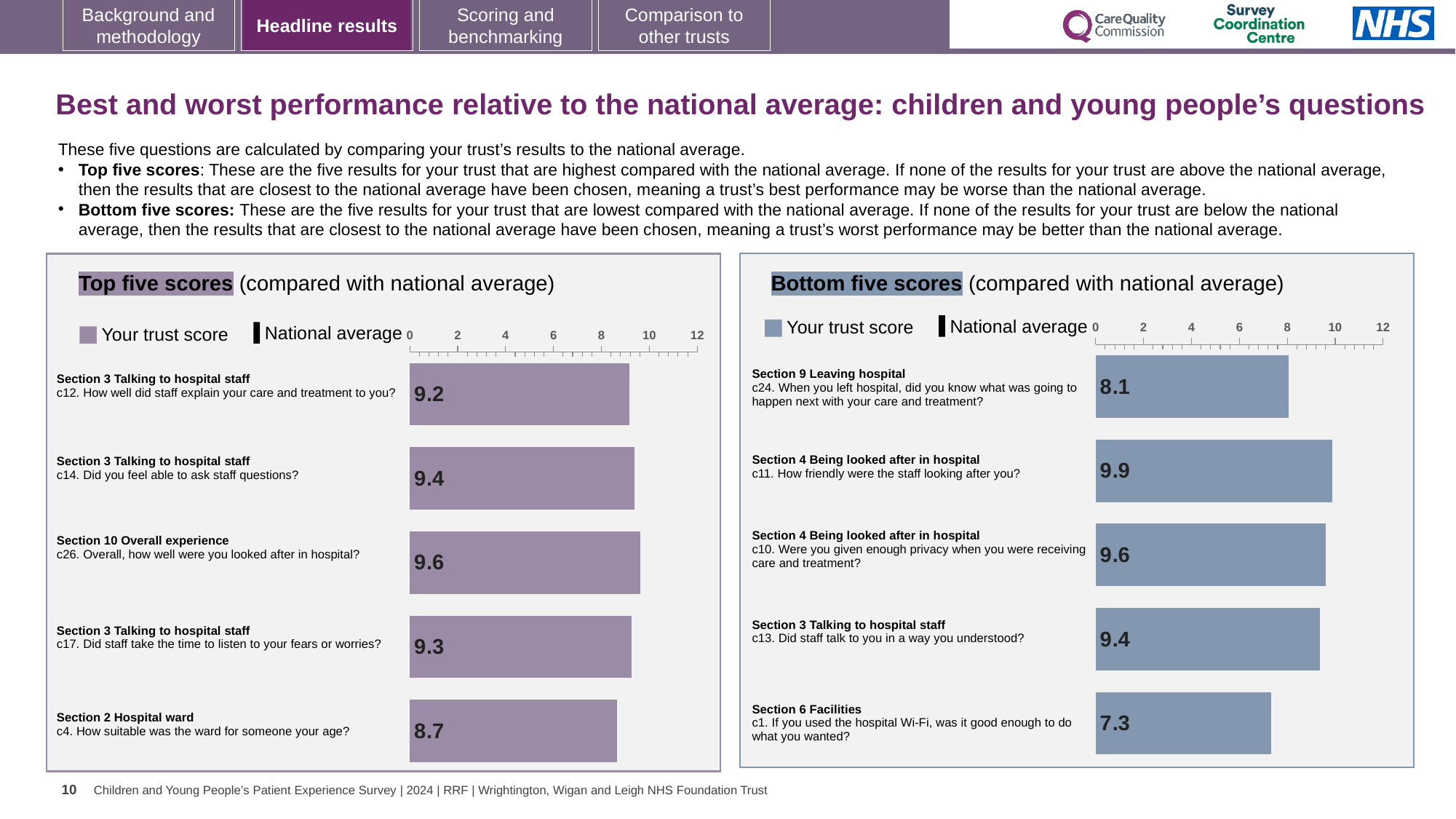
What kind of chart is the Bottom five scores chart? Bar chart In the Top five scores chart, which question has the highest trust score? c26. Overall, how well were you looked after in hospital? In the Bottom five scores chart, what is the trust score for c1 'If you used the hospital Wi-Fi, was it good enough to do what you wanted?' 7.3 How many questions (bars) are shown in the Top five scores chart? 5 In the Top five scores chart, which question has the lowest trust score? c4. How suitable was the ward for someone your age? In the Bottom five scores chart, which has the larger trust score: c24 'When you left hospital, did you know what was going to happen next' or c13 'Did staff talk to you in a way you understood?' c13. Did staff talk to you in a way you understood? In the Bottom five scores chart, what is the difference between the trust scores for c11 and c1? 2.6 How many entries does the legend of the Top five scores chart list? 2 In the Top five scores chart, what is the trust score for c14 'Did you feel able to ask staff questions?' 9.4 In the Bottom five scores chart, which question has the highest trust score? c11. How friendly were the staff looking after you? In the Bottom five scores chart, which question has the lowest trust score? c1. If you used the hospital Wi-Fi, was it good enough to do what you wanted? In the Top five scores chart, what is the difference between the trust scores for c26 and c4? 0.9